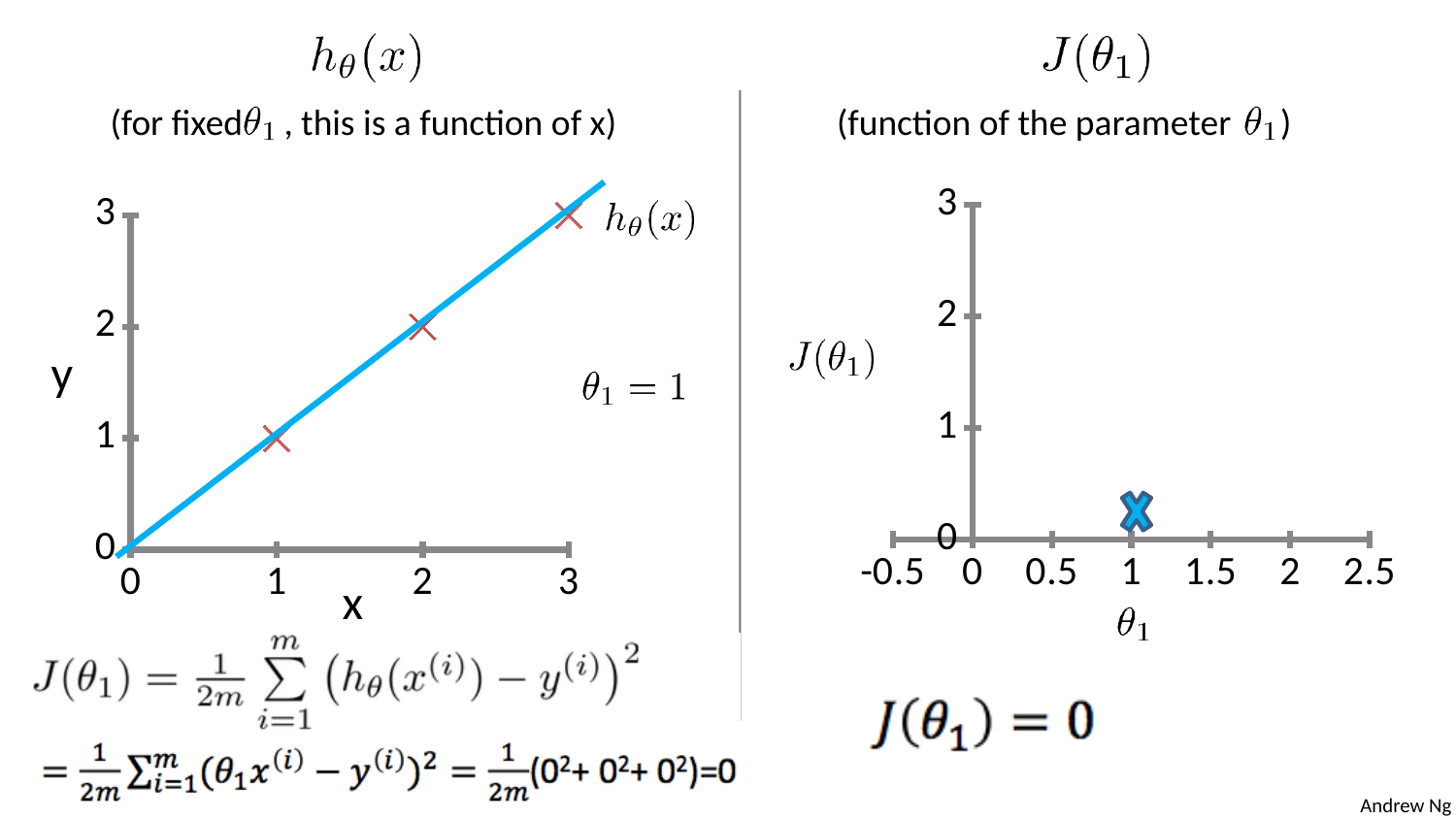
On the left chart titled h_θ(x), at which x value is the plotted y value highest? 3 On the left chart titled h_θ(x), what is the y value of the data point at x = 2? 2 On the left chart titled h_θ(x), how many red data points are plotted? 3 On the left chart titled h_θ(x), which is larger: the y value at x = 2 or the y value at x = 1? the y value at x = 2 On the left chart titled h_θ(x), what is the difference between the y value at x = 3 and the y value at x = 1? 2 On the left chart titled h_θ(x), what is the y value of the data point at x = 3? 3 On the left chart titled h_θ(x), what value of θ1 is shown for the plotted line? θ1 = 1 On the right chart titled J(θ1), how many points are plotted? 1 On the right chart titled J(θ1), is the plotted value at θ1 = 1 greater or less than 1? less On the right chart titled J(θ1), what is the value of J(θ1) at θ1 = 1? 0 On the left chart titled h_θ(x), at which x value is the plotted y value lowest? 1 On the left chart titled h_θ(x), do the y values rise or fall as x increases? rise